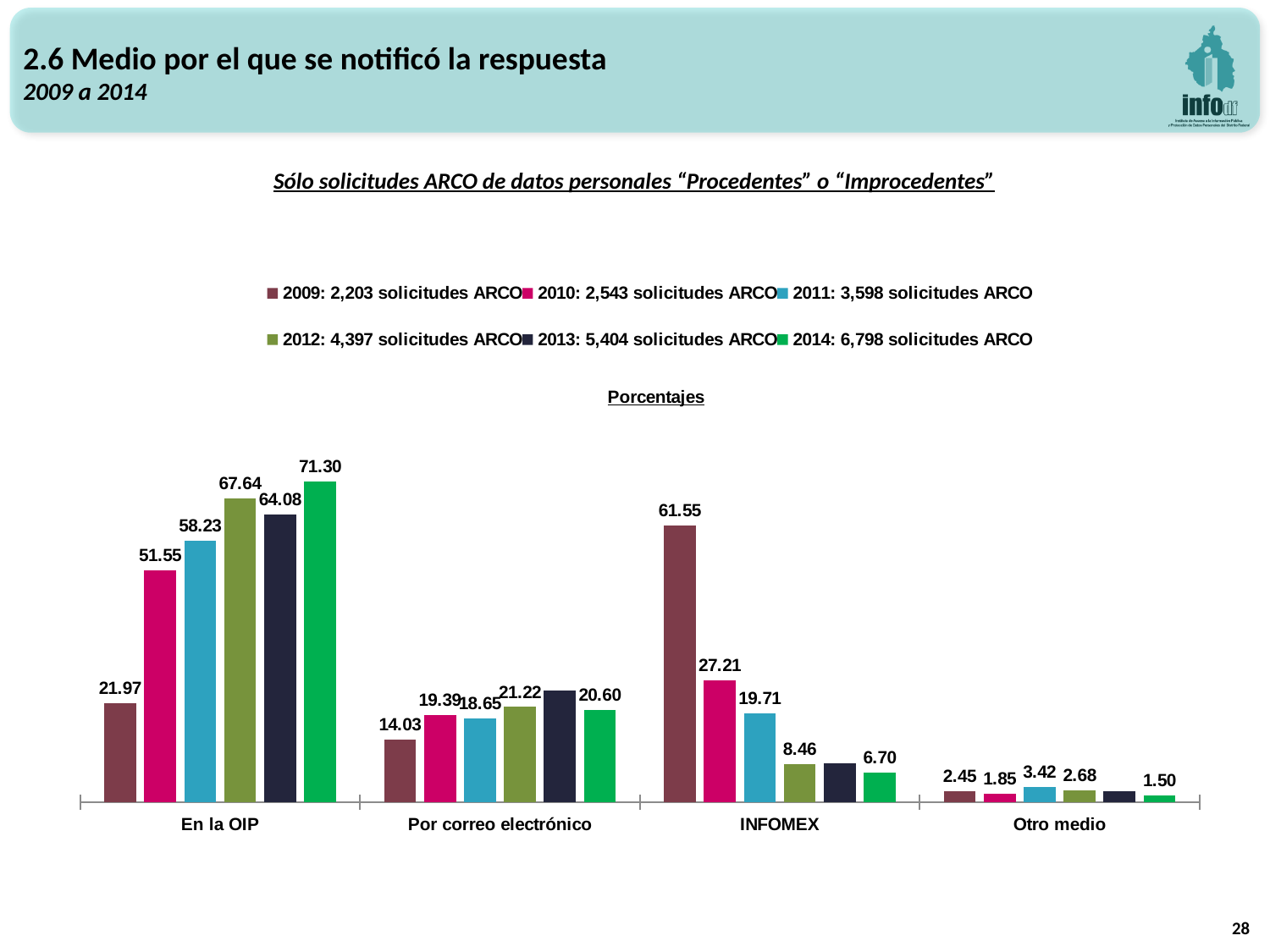
What is the value for 2012 in the Por correo electrónico category? 21.22 How many categories are shown on the x axis? 4 What is the value for 2014 in the En la OIP category? 71.30 What is the difference between the 2009 and 2010 values in the INFOMEX category? 34.34 What kind of chart is shown on the slide? bar chart Do the INFOMEX values rise or fall from 2009 to 2014? fall In the Por correo electrónico category, which is larger: the 2010 value or the 2011 value? 2010 Which year has the highest value in the En la OIP category? 2014 What is the value for 2009 in the INFOMEX category? 61.55 How many series does the legend list? 6 What is the difference between the 2014 and 2009 values in the En la OIP category? 49.33 Which year has the lowest value in the Otro medio category? 2014